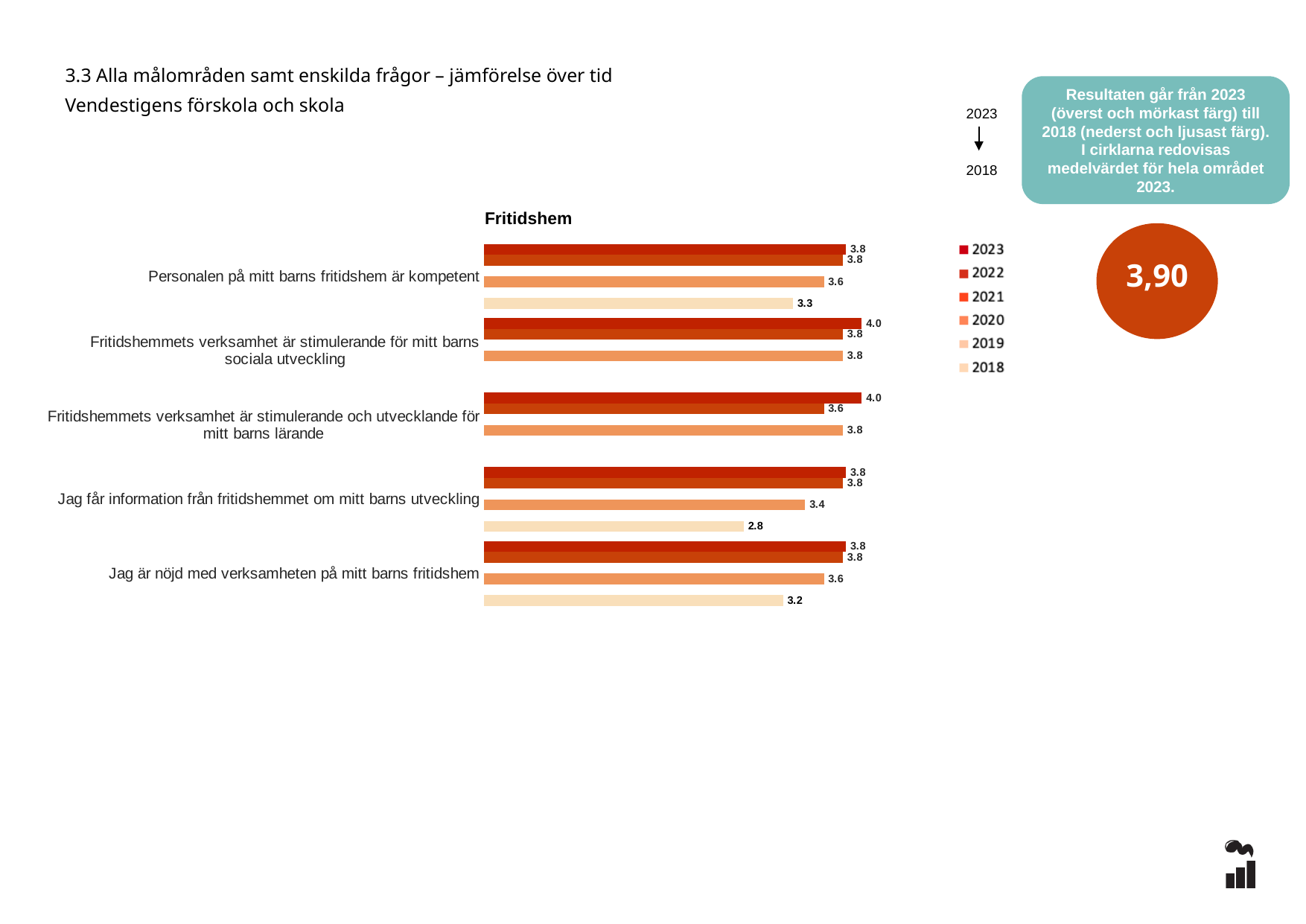
What is the 2018 value (lightest, bottom bar) for "Jag får information från fritidshemmet om mitt barns utveckling"? 2.8 For "Jag får information från fritidshemmet om mitt barns utveckling", how much higher is the 2023 value than the 2018 value? 1.0 What is the 2023 value (topmost bar) for "Fritidshemmets verksamhet är stimulerande för mitt barns sociala utveckling"? 4.0 What is the 2023 value (topmost, darkest bar) for "Personalen på mitt barns fritidshem är kompetent"? 3.8 How many years does the legend of the Fritidshem chart list? 6 Which has the higher 2023 value: "Fritidshemmets verksamhet är stimulerande och utvecklande för mitt barns lärande" or "Jag är nöjd med verksamheten på mitt barns fritidshem"? Fritidshemmets verksamhet är stimulerande och utvecklande för mitt barns lärande What is the 2018 value (lightest, bottom bar) for "Jag är nöjd med verksamheten på mitt barns fritidshem"? 3.2 What is the lowest value shown anywhere in the Fritidshem chart? 2.8 What mean value for the whole area in 2023 is shown in the orange circle next to the chart? 3,90 For "Personalen på mitt barns fritidshem är kompetent", what is the difference between the 2023 value and the 2018 value? 0.5 What kind of chart is shown under the heading "Fritidshem"? Bar chart How many statements (categories) are plotted in the Fritidshem chart? 5